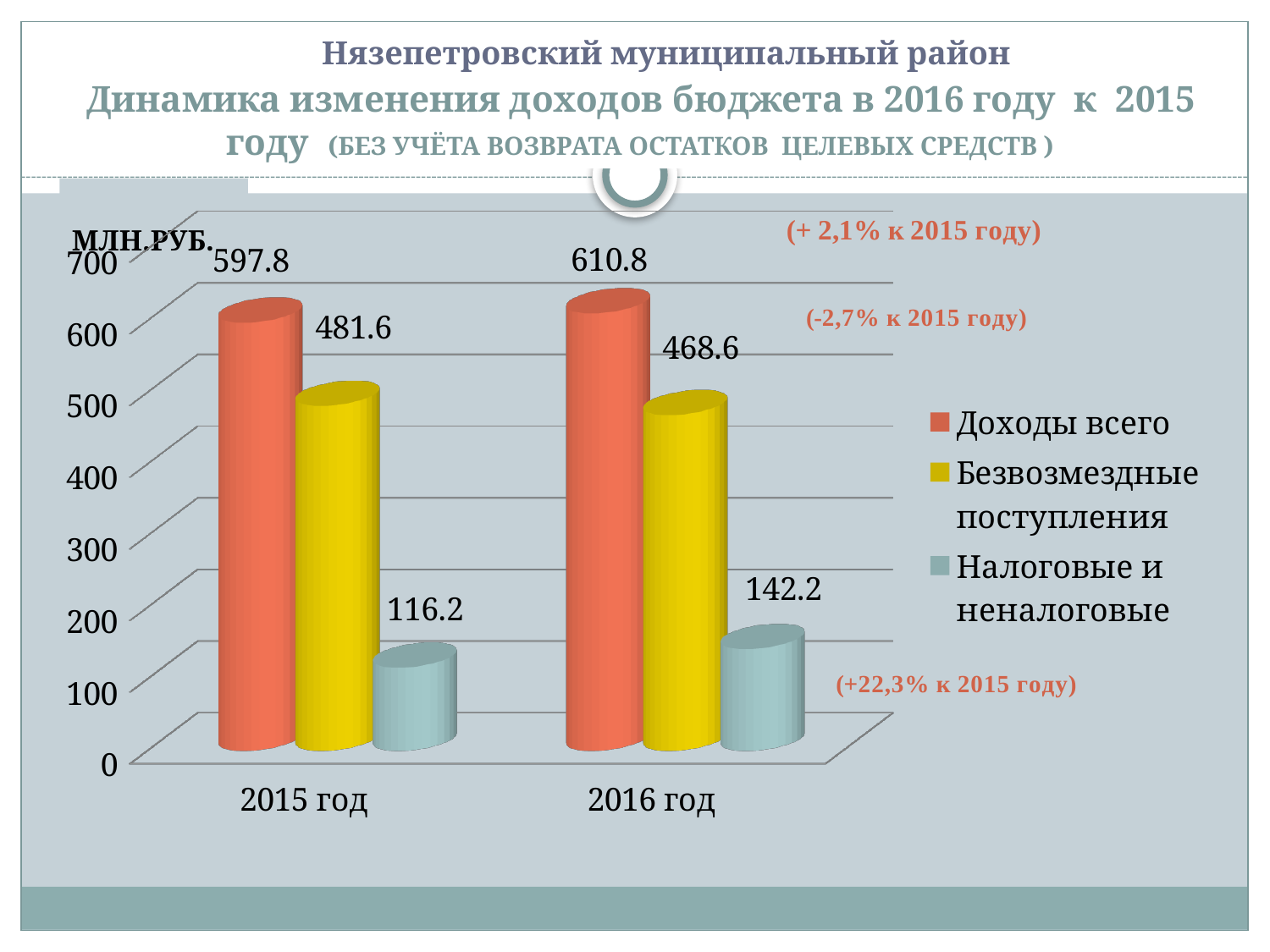
How many categories are shown on the x axis? 2 What is the value of Налоговые и неналоговые for 2016 год? 142.2 What is the value of Доходы всего for 2016 год? 610.8 What kind of chart is shown on the slide? bar chart What is the difference between Безвозмездные поступления in 2015 год and in 2016 год? 13.0 Which series has the highest value in 2016 год? Доходы всего Which series has the lowest value in 2015 год? Налоговые и неналоговые What is the difference between Доходы всего in 2016 год and in 2015 год? 13.0 Which is larger: Налоговые и неналоговые in 2015 год or in 2016 год? 2016 год What is the value of Безвозмездные поступления for 2015 год? 481.6 How many series does the legend list? 3 What unit is indicated for the values on the chart? МЛН.РУБ.